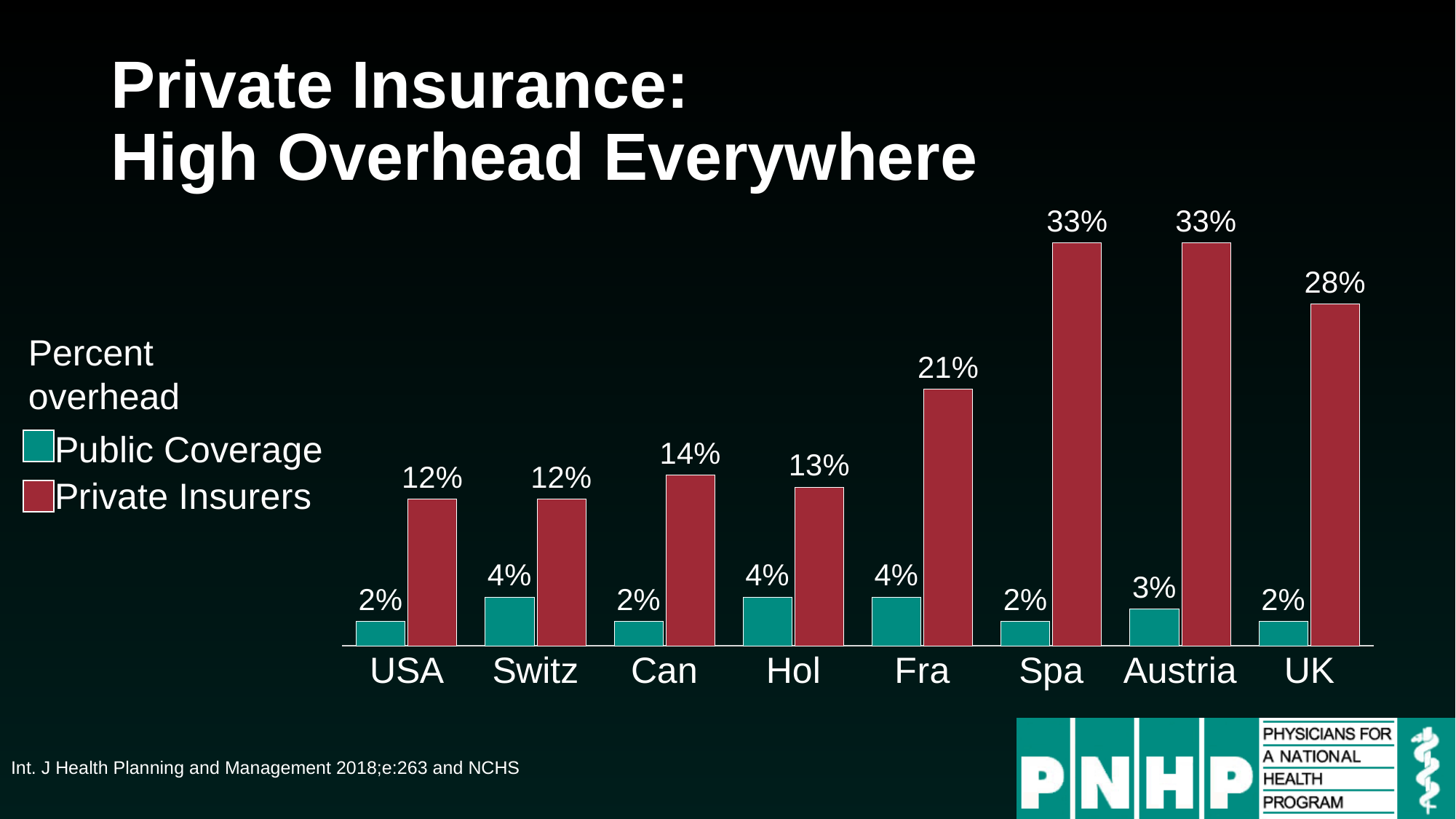
Which is larger, the Private Insurers overhead for Hol or for Fra? Fra Which country has the lowest Private Insurers overhead? USA and Switz (12%) What is the difference between the Private Insurers and Public Coverage overhead for Can? 12% What is the Private Insurers overhead value for Fra? 21% Which countries have the highest Private Insurers overhead? Spa and Austria (33%) What is the Public Coverage overhead value for Austria? 3% Which colour represents Private Insurers in the legend? Red What is the Public Coverage overhead value for Switz? 4% What is the Private Insurers overhead value for the UK? 28% How many series does the legend list? 2 What kind of chart is shown on the slide? Bar chart How many countries are shown on the x axis? 8